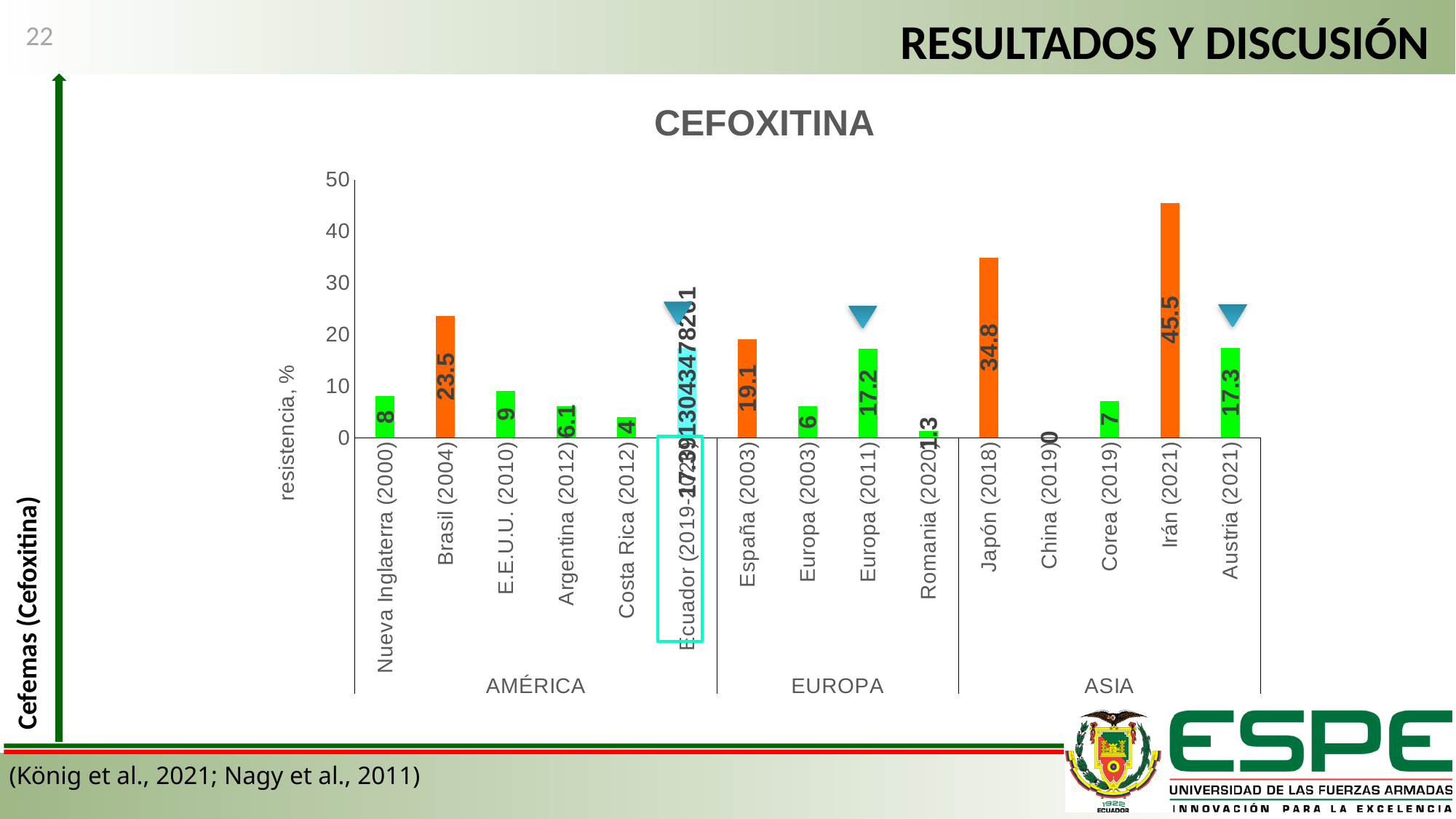
Which category has the lowest resistance value? China (2019) What is the resistance value for Irán (2021)? 45.5 Which category has the highest resistance value? Irán (2021) What is the resistance value for Romania (2020)? 1.3 Which is larger, the value for Japón (2018) or the value for Brasil (2004)? Japón (2018) What is the title of the chart? CEFOXITINA What kind of chart is shown on the slide? bar chart What is the difference between the values for Brasil (2004) and España (2003)? 4.4 What is the resistance value for Brasil (2004)? 23.5 What is the resistance value for Japón (2018)? 34.8 How many categories (bars) are shown in the chart? 15